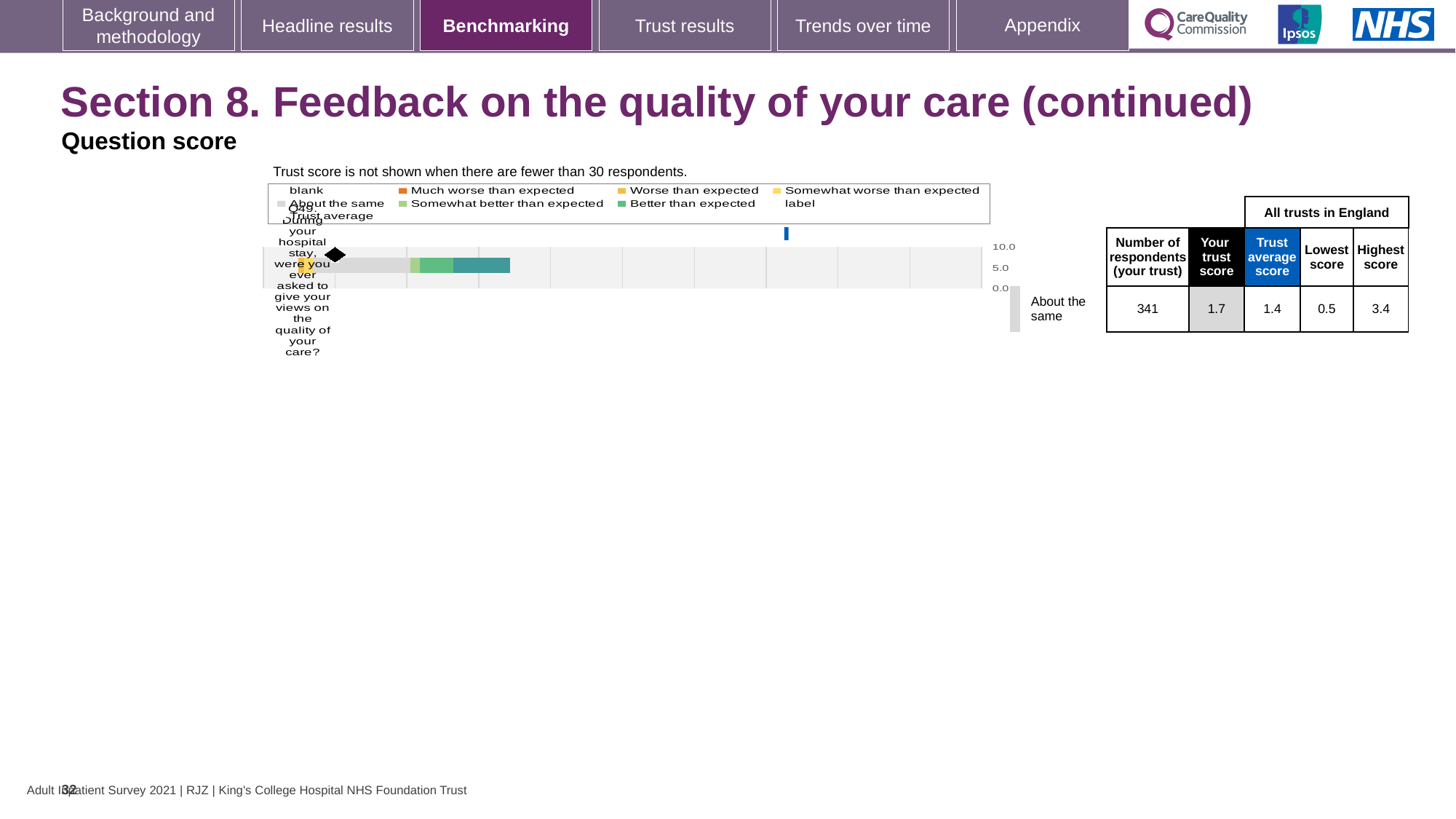
By how much does your trust score exceed the trust average score for Q49? 0.3 Is the trust score marker for Q49 plotted at a value greater or less than 5.0 on the axis? less What is the lowest score for Q49 among all trusts in England? 0.5 How many respondents from your trust answered Q49? 341 What is the highest score for Q49 among all trusts in England? 3.4 What kind of chart is used to show the Q49 benchmarking result? bar chart What is the trust average score for Q49 across all trusts in England? 1.4 How many questions are plotted in the benchmarking chart? 1 What benchmark category label is shown for Q49 to the right of the chart? About the same Which is larger for Q49: your trust score or the trust average score? Your trust score What is the 'Your trust score' for Q49 shown next to the chart? 1.7 What is the difference between the highest score and the lowest score for Q49? 2.9